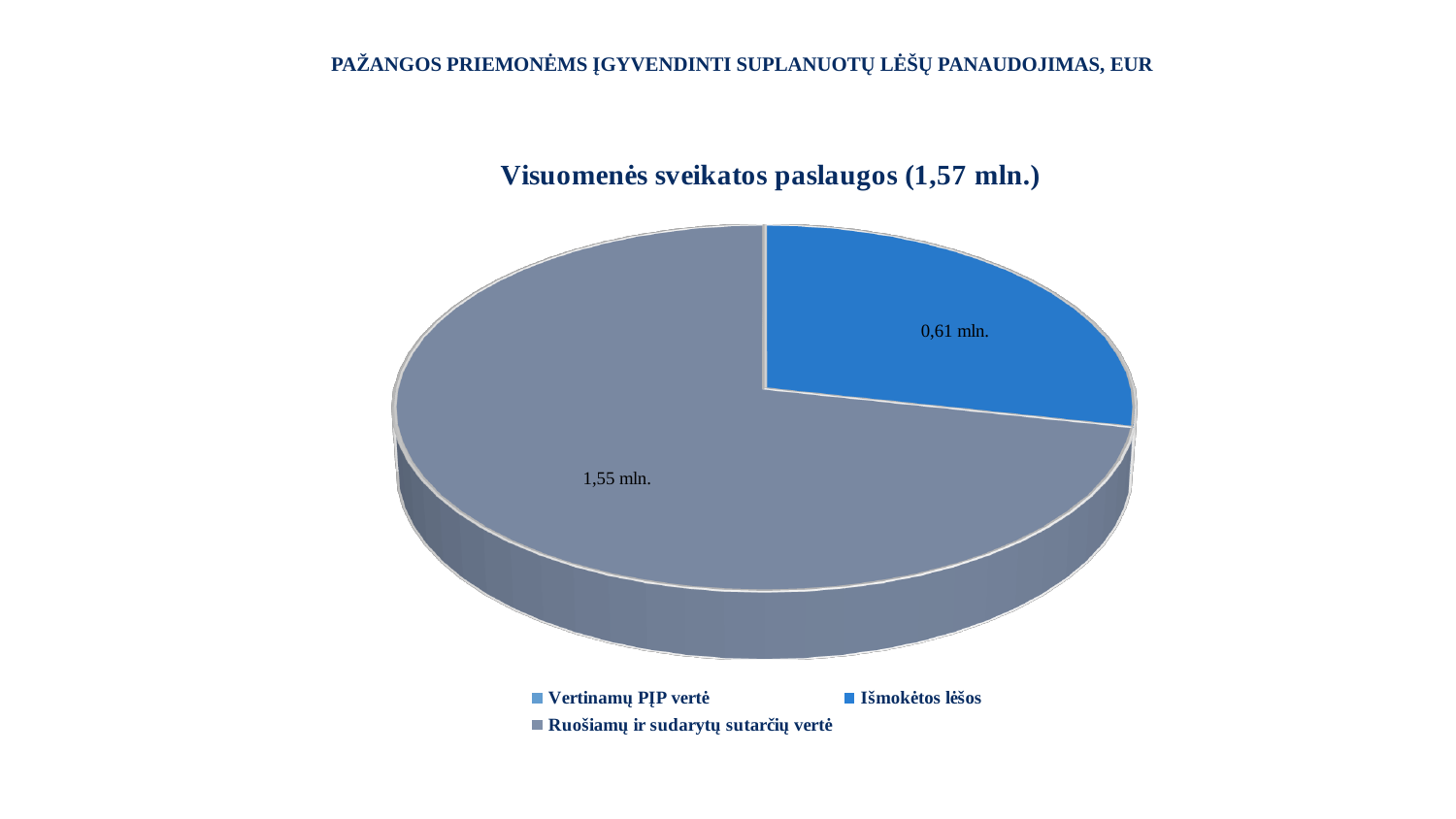
How many slices in the pie have a data label? 2 What is the value shown for the blue slice (Išmokėtos lėšos)? 0,61 mln. What is the value shown for the grey slice (Ruošiamų ir sudarytų sutarčių vertė)? 1,55 mln. Which is larger: the slice labelled 1,55 mln. or the slice labelled 0,61 mln.? the slice labelled 1,55 mln. What kind of chart is shown on the slide? pie chart How many entries does the legend list? 3 Which slice of the pie is the largest? Ruošiamų ir sudarytų sutarčių vertė Which of the two labelled slices is the smallest? Išmokėtos lėšos What is the title of the pie chart? Visuomenės sveikatos paslaugos (1,57 mln.) What is the difference between the 1,55 mln. slice and the 0,61 mln. slice? 0,94 mln. What amount is given in parentheses in the chart title? 1,57 mln.